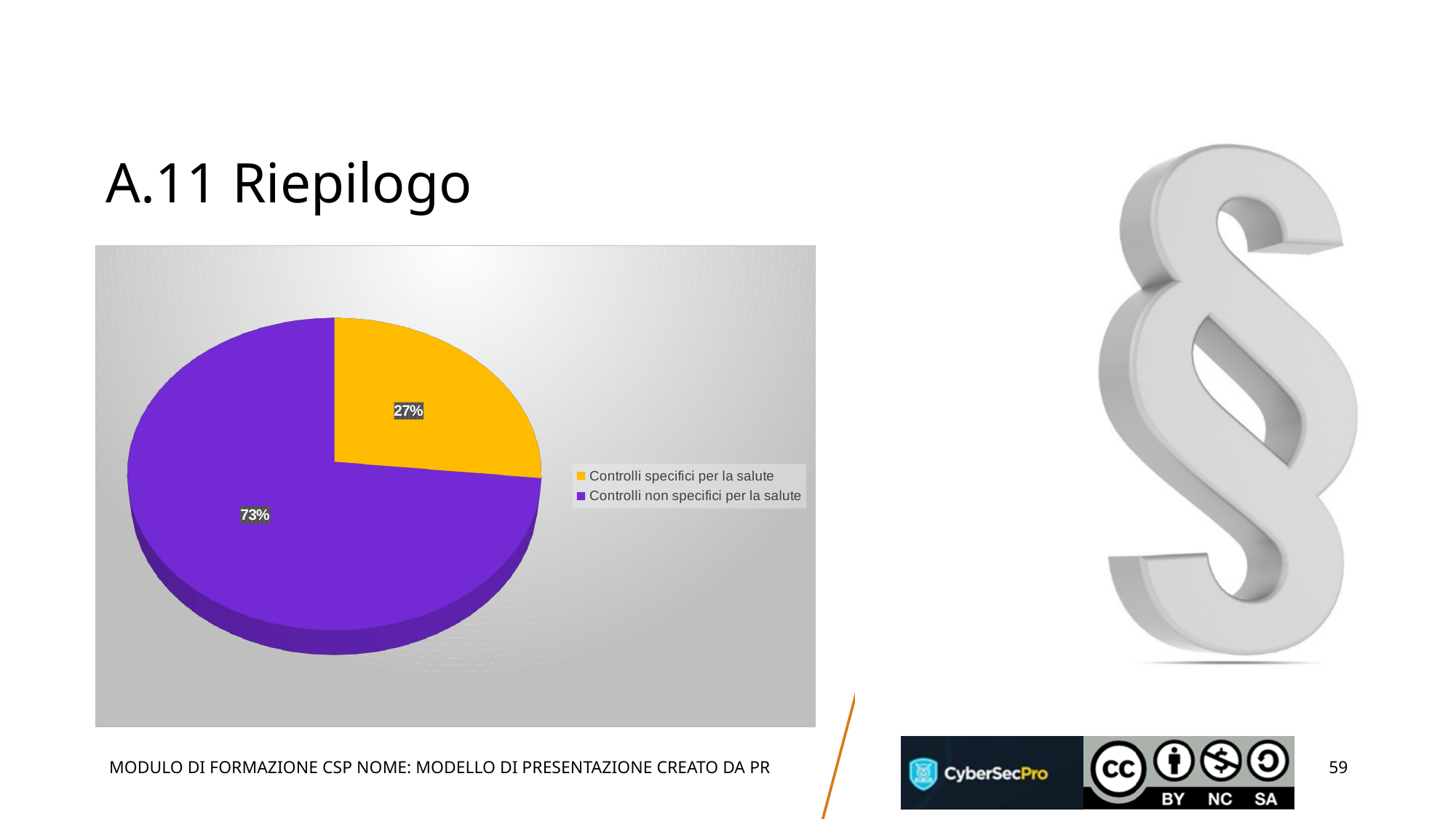
Which is larger: 'Controlli specifici per la salute' or 'Controlli non specifici per la salute'? Controlli non specifici per la salute How many entries does the legend list? 2 Which slice of the pie is the largest? Controlli non specifici per la salute What colour is the slice for 'Controlli specifici per la salute'? Orange What kind of chart is shown on the slide? Pie chart What percentage of the pie is 'Controlli specifici per la salute'? 27% Which slice of the pie is the smallest? Controlli specifici per la salute What colour is the slice for 'Controlli non specifici per la salute'? Purple What share of the pie does the purple slice represent? 73% What is the difference in percentage points between 'Controlli non specifici per la salute' and 'Controlli specifici per la salute'? 46 How many slices does the pie chart have? 2 What percentage of the pie is 'Controlli non specifici per la salute'? 73%